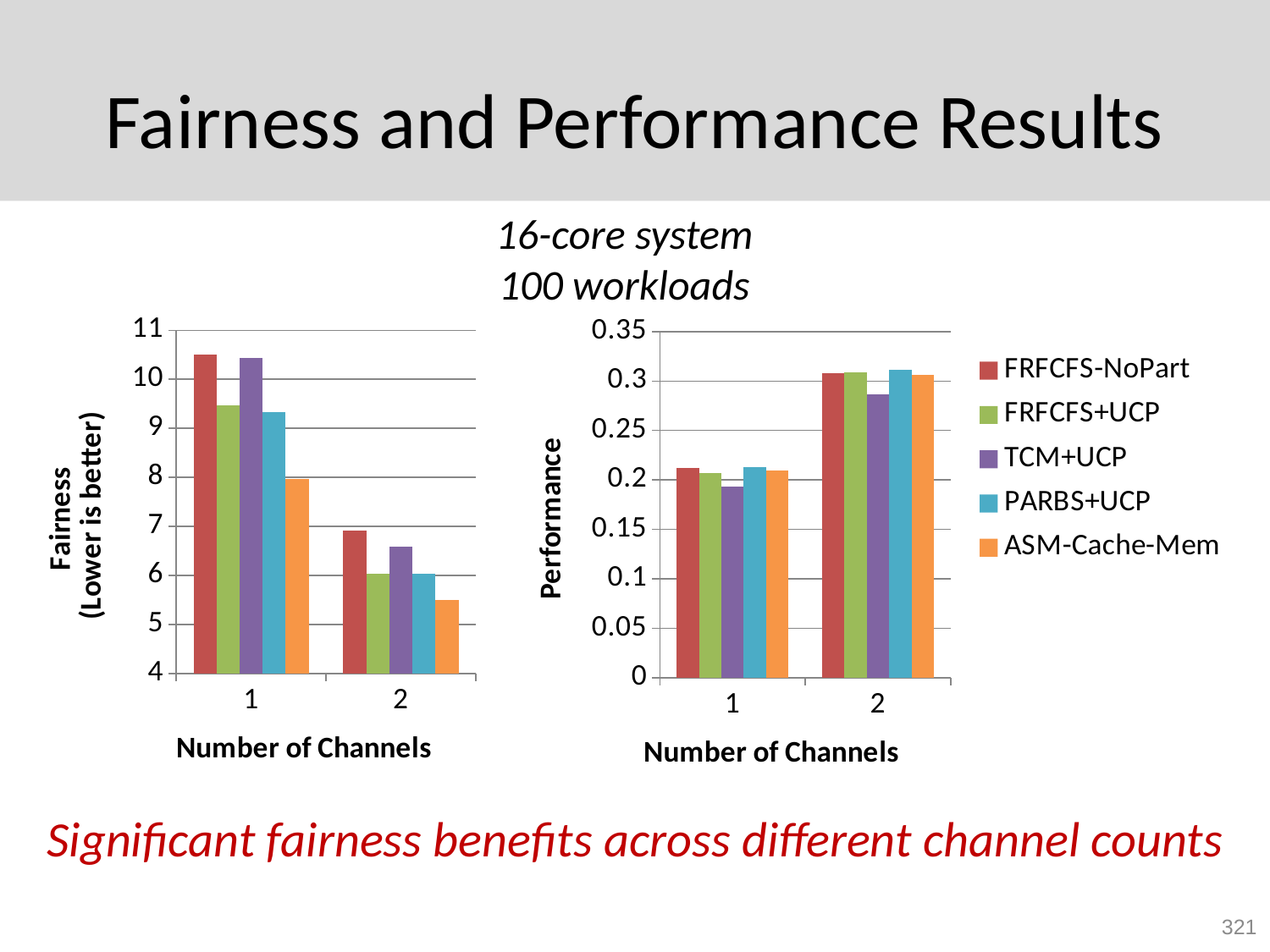
In the right chart (Performance), is the value for TCM+UCP at 1 channel greater or less than 0.2? less In the right chart (Performance), is the value for PARBS+UCP at 2 channels greater or less than 0.3? greater In the left chart (Fairness), is the value for ASM-Cache-Mem at 2 channels greater or less than 6? less In the left chart (Fairness), which series has the lowest value at 2 channels? ASM-Cache-Mem What is the x-axis title of the right chart (Performance)? Number of Channels In the right chart (Performance), do the values for ASM-Cache-Mem rise or fall from 1 channel to 2 channels? rise In the left chart (Fairness), which is larger for FRFCFS-NoPart: the value at 1 channel or at 2 channels? 1 channel How many series does the legend list? 5 In the left chart (Fairness), how many categories are shown on the x axis? 2 In the left chart (Fairness), which series has the lowest value at 1 channel? ASM-Cache-Mem What kind of chart is the left chart (Fairness)? bar chart